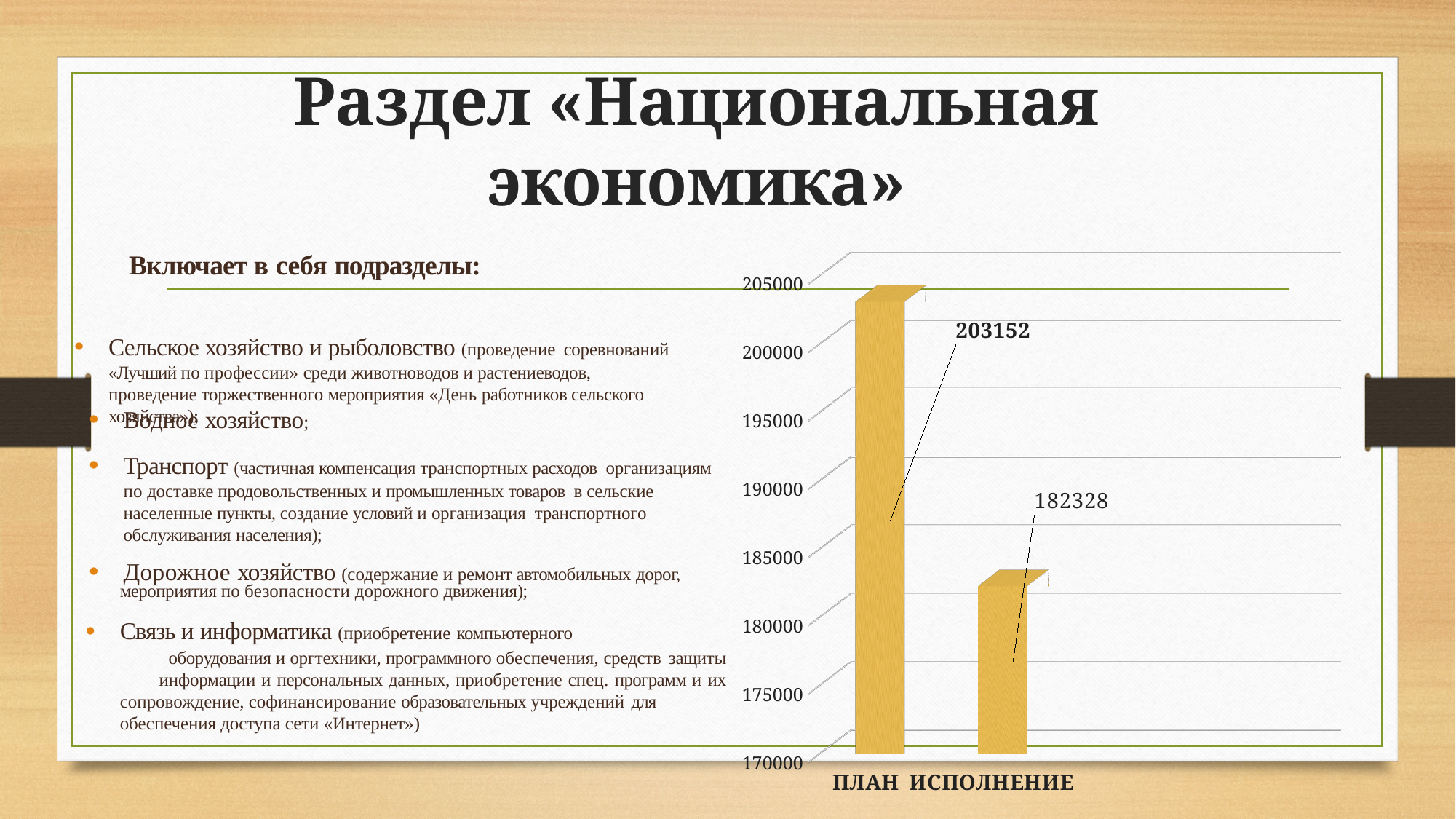
Is the value for ИСПОЛНЕНИЕ greater or less than 185000? less Is the value for ПЛАН greater or less than 200000? greater Which is larger, the value for ПЛАН or the value for ИСПОЛНЕНИЕ? ПЛАН What is the difference between the values for ПЛАН and ИСПОЛНЕНИЕ? 20824 Do the values rise or fall from ПЛАН to ИСПОЛНЕНИЕ? fall How many bars are shown in the chart? 2 Which category has the highest value? ПЛАН Which category has the lowest value? ИСПОЛНЕНИЕ What is the value for ИСПОЛНЕНИЕ? 182328 What kind of chart is shown on the slide? bar chart What is the lowest value shown on the vertical axis of the chart? 170000 What is the value for ПЛАН? 203152